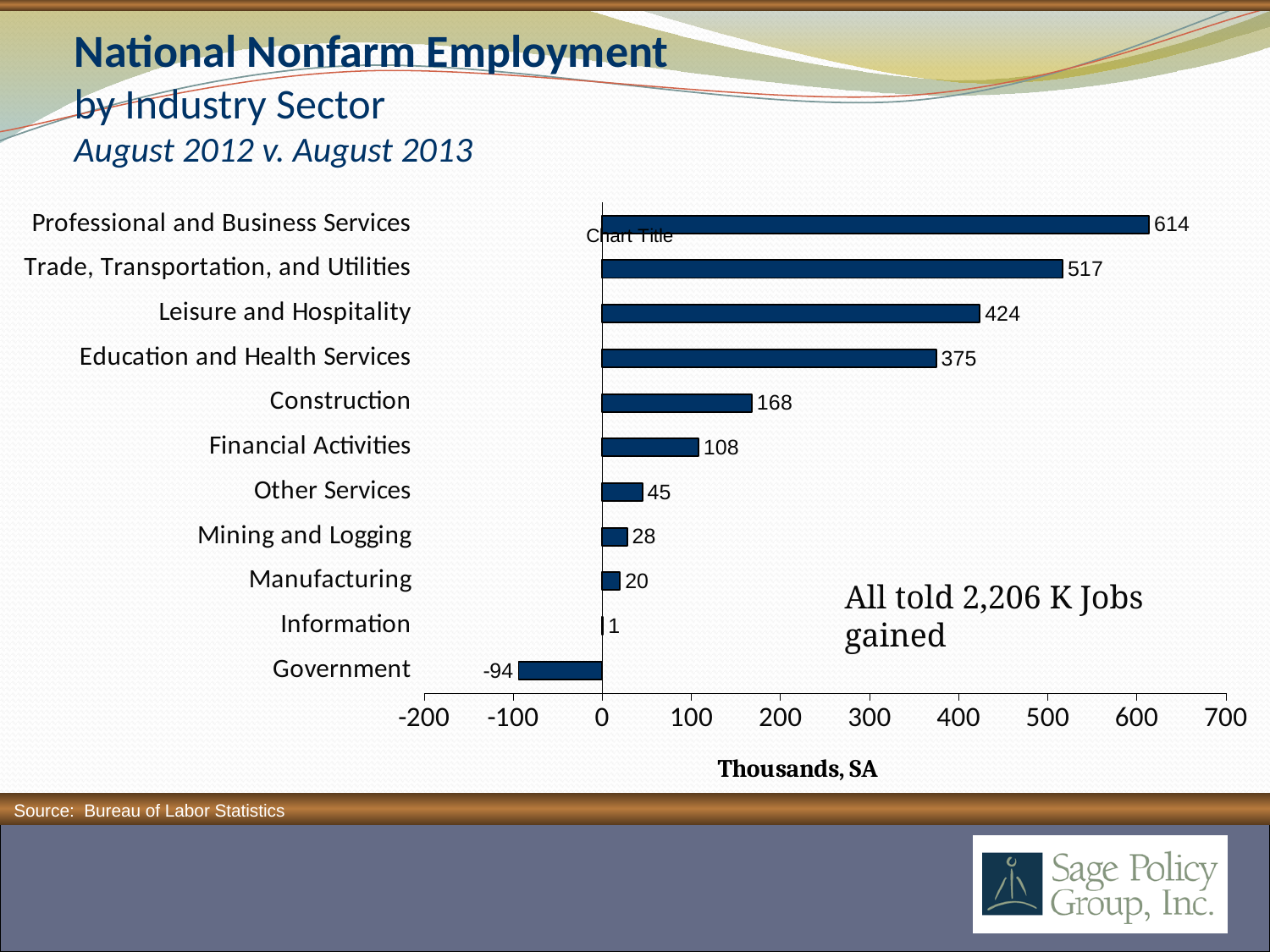
What is the value for Information? 1 What is the value for Professional and Business Services? 614 What is the value for Government? -94 Is the value for Education and Health Services greater or less than 300? greater Which industry sector has the highest value? Professional and Business Services What is the unit label shown on the x axis of the chart? Thousands, SA How many industry sectors are shown in the chart? 11 What is the value for Construction? 168 Which industry sector has the lowest value? Government Which is larger, the value for Financial Activities or the value for Other Services? Financial Activities What kind of chart is shown on the slide? bar chart What is the difference between the values for Trade, Transportation, and Utilities and Leisure and Hospitality? 93